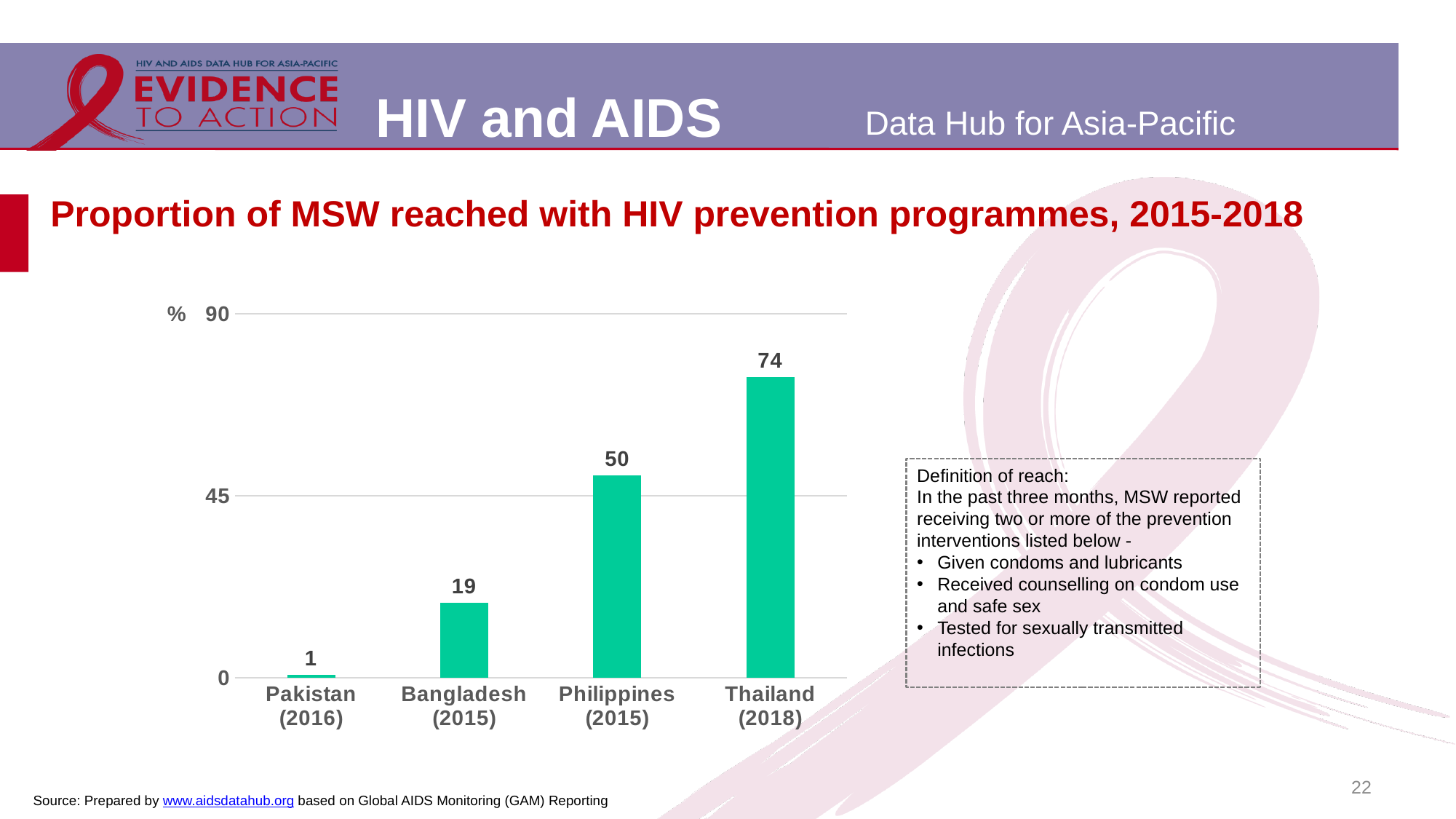
Is the value for Philippines (2015) greater or less than 45? greater What is the title of the chart? Proportion of MSW reached with HIV prevention programmes, 2015-2018 Which country has the lowest proportion of MSW reached? Pakistan (2016) Which is larger, the value for Philippines (2015) or Bangladesh (2015)? Philippines (2015) What is the difference between the values for Thailand (2018) and Philippines (2015)? 24 What is the value for Bangladesh (2015)? 19 What is the value for Pakistan (2016)? 1 What is the difference between the values for Bangladesh (2015) and Pakistan (2016)? 18 Which country has the highest proportion of MSW reached? Thailand (2018) How many countries are shown in the chart? 4 What is the value for Thailand (2018)? 74 What kind of chart is shown on the slide? bar chart